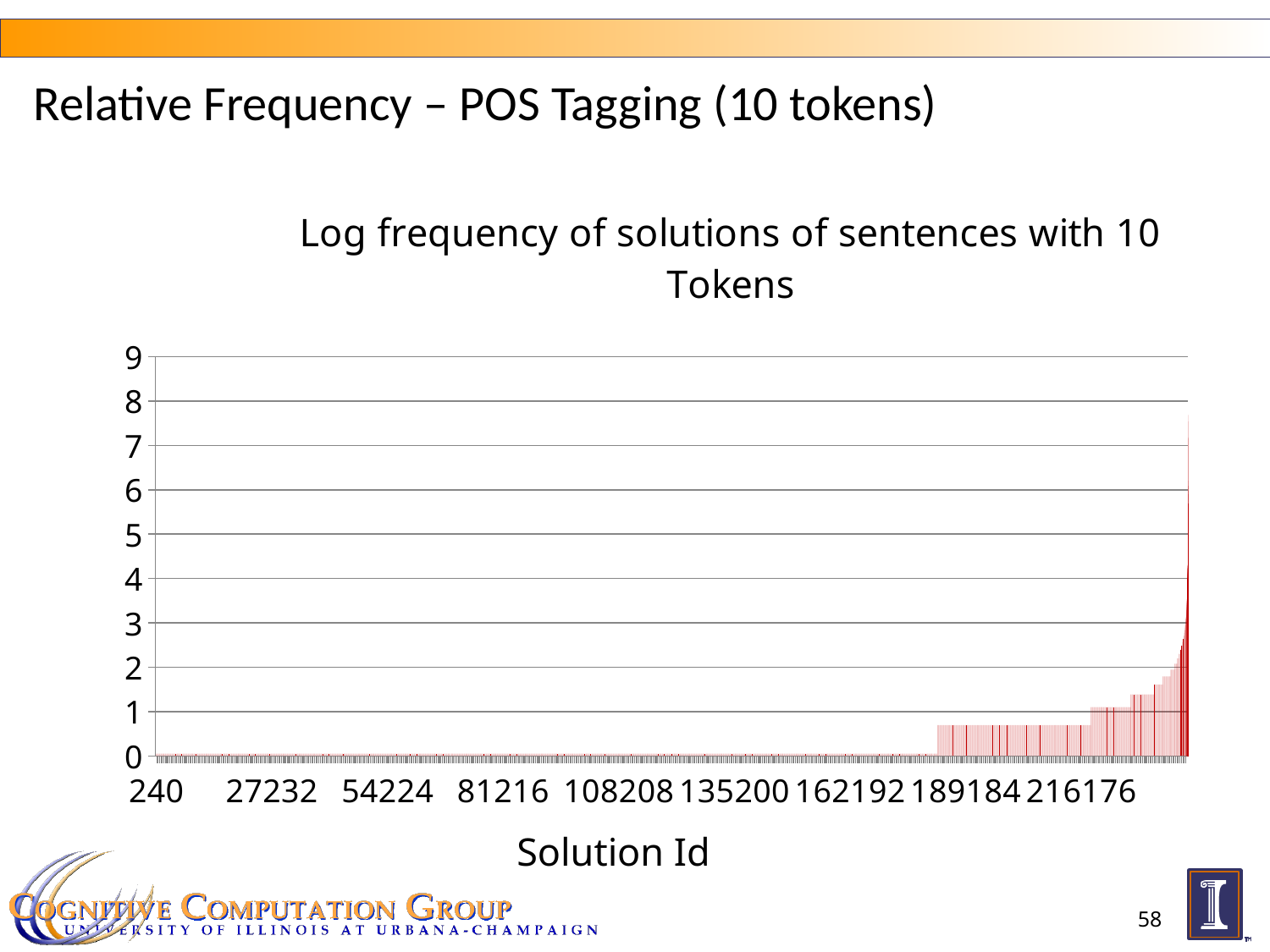
Which end of the x axis has the tallest bars, the left end or the right end? right end What is the highest tick value shown on the y axis? 9 What is the label of the x axis? Solution Id Do the bar values generally rise or fall moving from left to right along the x axis? rise Are the bar values near Solution Id 216176 greater or less than 3? less What is the title of the chart? Log frequency of solutions of sentences with 10 Tokens Is the value of the tallest bar greater or less than 8? less Are the bar values near Solution Id 240 greater or less than 1? less How many tick labels are shown on the x axis? 9 What kind of chart is shown on the slide? bar chart